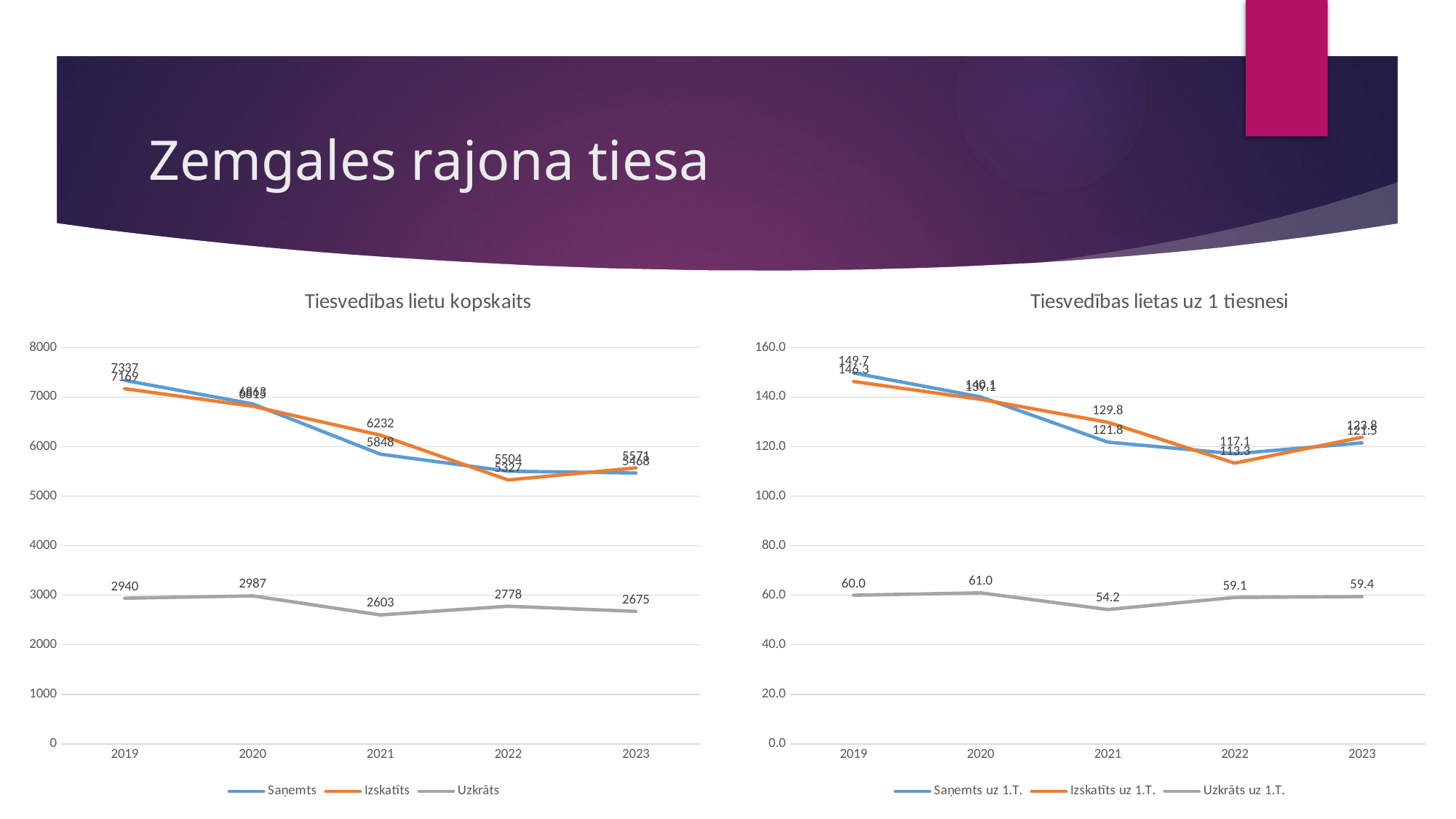
In the 'Tiesvedības lietu kopskaits' chart, what is the difference between the Saņemts and Izskatīts values in 2019? 168 In the 'Tiesvedības lietu kopskaits' chart, how many series does the legend list? 3 What kind of chart is the 'Tiesvedības lietu kopskaits' chart on the left? line chart In the 'Tiesvedības lietas uz 1 tiesnesi' chart, how many years are shown on the x axis? 5 In the 'Tiesvedības lietu kopskaits' chart, what is the Izskatīts value for 2021? 6232 In the 'Tiesvedības lietu kopskaits' chart, what is the Uzkrāts value for 2021? 2603 In the 'Tiesvedības lietas uz 1 tiesnesi' chart, what is the Izskatīts uz 1.T. value for 2022? 113.3 In the 'Tiesvedības lietu kopskaits' chart, in which year is the Uzkrāts value highest? 2020 In the 'Tiesvedības lietas uz 1 tiesnesi' chart, in which year is the Uzkrāts uz 1.T. value lowest? 2021 In the 'Tiesvedības lietu kopskaits' chart, what is the Saņemts value for 2019? 7337 In the 'Tiesvedības lietas uz 1 tiesnesi' chart, which is larger in 2021: Saņemts uz 1.T. or Izskatīts uz 1.T.? Izskatīts uz 1.T. In the 'Tiesvedības lietas uz 1 tiesnesi' chart, what is the Uzkrāts uz 1.T. value for 2021? 54.2